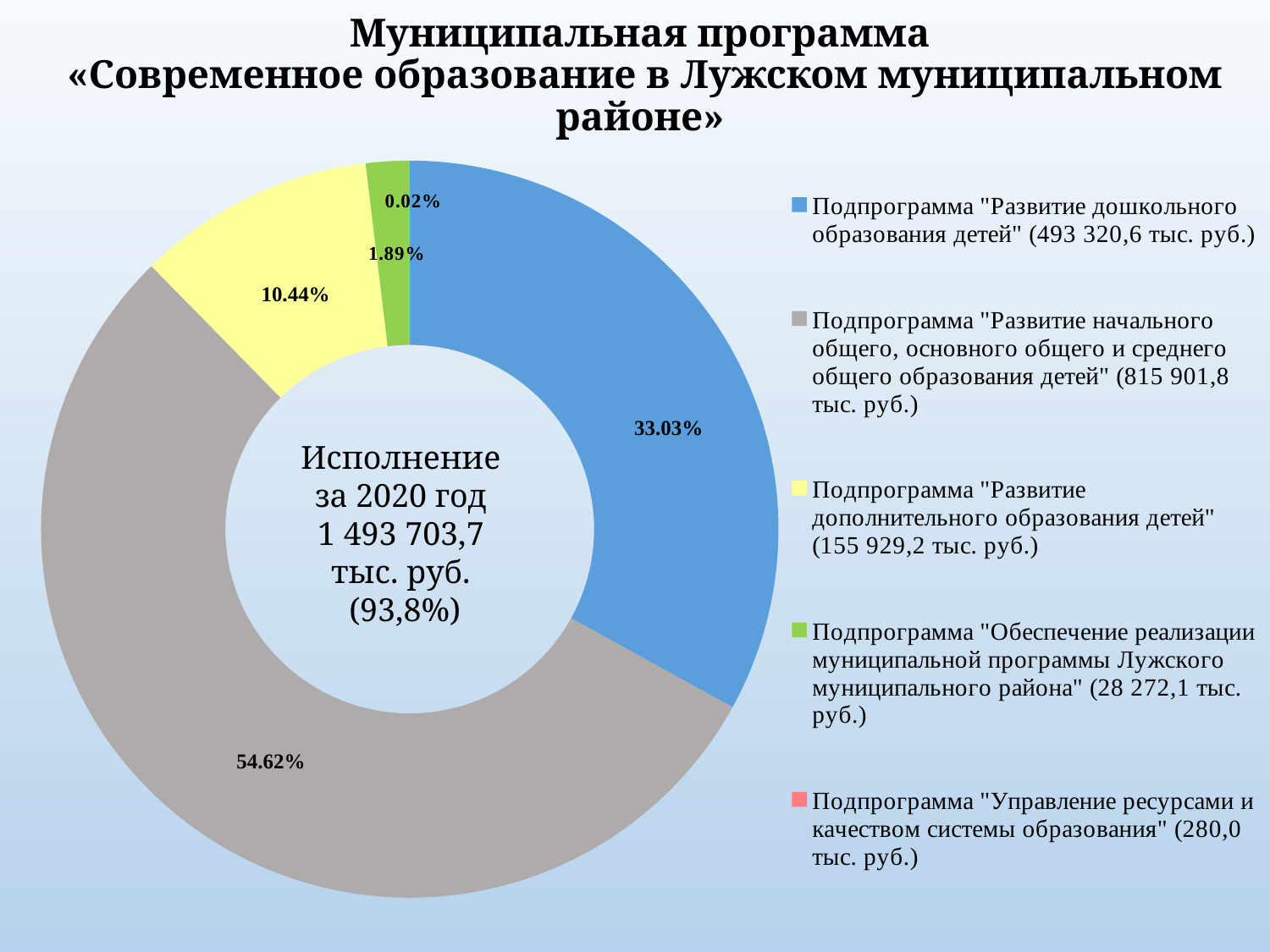
Which has a larger share: the subprogram "Развитие дополнительного образования детей" or the subprogram "Обеспечение реализации муниципальной программы Лужского муниципального района"? Подпрограмма "Развитие дополнительного образования детей" What kind of chart is shown on the slide? Doughnut (pie) chart How many slices does the doughnut chart have? 5 Which subprogram has the smallest share of the chart? Подпрограмма "Управление ресурсами и качеством системы образования" Which subprogram has the largest share of the chart? Подпрограмма "Развитие начального общего, основного общего и среднего общего образования детей" What share of the chart does the subprogram "Развитие дополнительного образования детей" take? 10.44% What share of the chart does the subprogram "Развитие дошкольного образования детей" take? 33.03% What total amount of execution for 2020 is shown in the centre of the doughnut chart? 1 493 703,7 тыс. руб. (93,8%) What share of the chart does the subprogram "Обеспечение реализации муниципальной программы Лужского муниципального района" take? 1.89% What is the difference in percentage points between the shares of the general education subprogram (54.62%) and the preschool education subprogram (33.03%)? 21.59